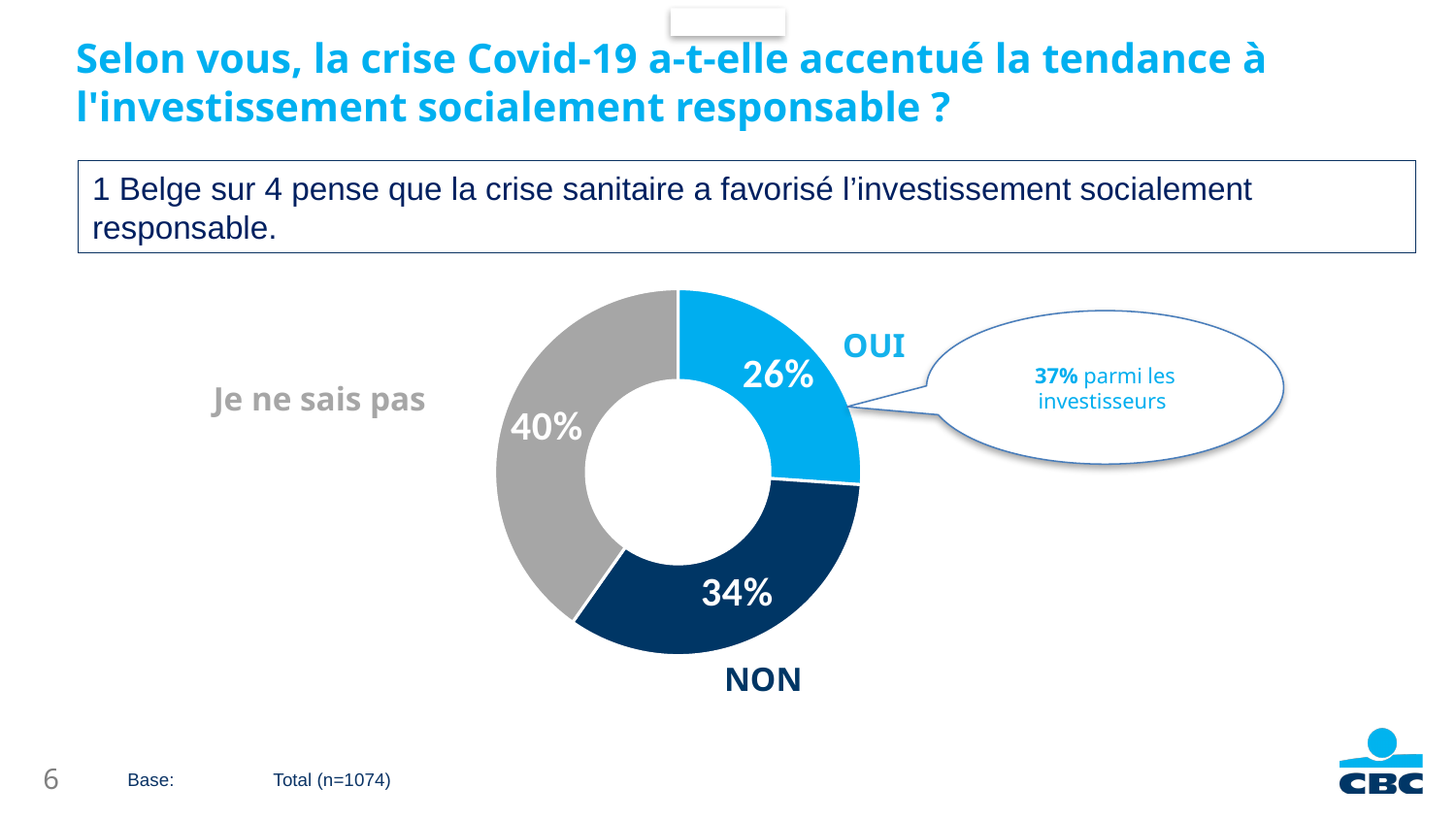
According to the callout, what percentage of investors answered OUI? 37% What percentage of respondents answered 'Je ne sais pas'? 40% How many categories are shown in the pie chart? 3 What colour is the OUI slice of the pie chart? Light blue Which response has the largest share of the pie? Je ne sais pas What percentage of respondents answered NON? 34% What is the difference in percentage points between NON and OUI? 8 What kind of chart is shown on the slide? Pie chart (doughnut) What is the difference in percentage points between 'Je ne sais pas' and NON? 6 Which response has the smallest share of the pie? OUI Which is larger, the share for NON or the share for OUI? NON What percentage of respondents answered OUI? 26%